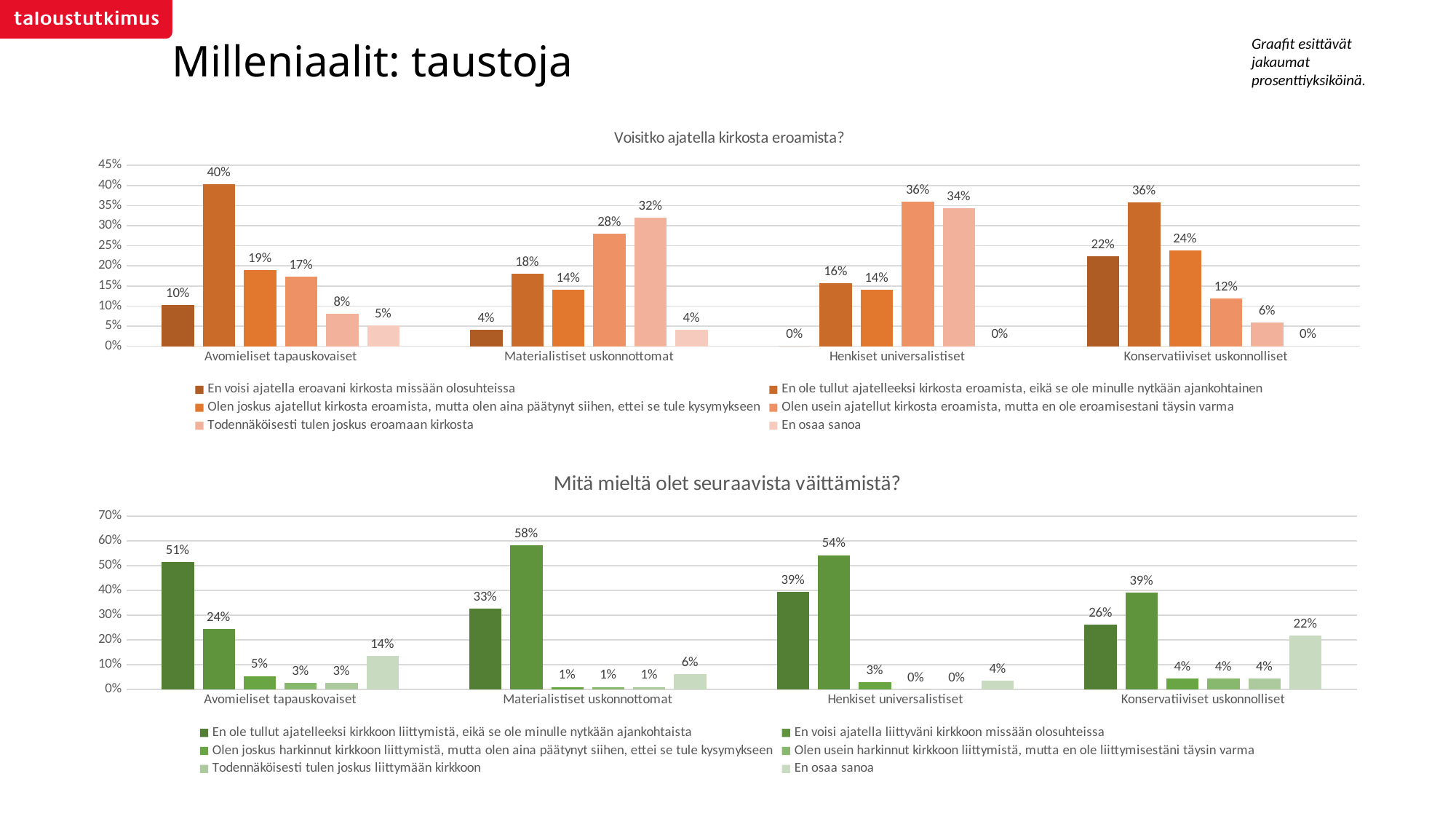
In the bottom chart 'Mitä mieltä olet seuraavista väittämistä?', what is the difference in percentage points between Materialistiset uskonnottomat (58%) and Henkiset universalistiset (54%) for 'En voisi ajatella liittyväni kirkkoon missään olosuhteissa'? 4 percentage points What is the title of the top chart on the slide? Voisitko ajatella kirkosta eroamista? In the bottom chart 'Mitä mieltä olet seuraavista väittämistä?', which category has the single highest bar, and what is its value? Materialistiset uskonnottomat, 58% How many categories are shown on the x axis of the top chart 'Voisitko ajatella kirkosta eroamista?'? 4 What kind of chart is the bottom chart 'Mitä mieltä olet seuraavista väittämistä?'? Bar chart In the top chart 'Voisitko ajatella kirkosta eroamista?', which category has the highest value for 'En voisi ajatella eroavani kirkosta missään olosuhteissa'? Konservatiiviset uskonnolliset In the bottom chart 'Mitä mieltä olet seuraavista väittämistä?', which is larger for 'En ole tullut ajatelleeksi kirkkoon liittymistä, eikä se ole minulle nytkään ajankohtaista': Avomieliset tapauskovaiset or Henkiset universalistiset? Avomieliset tapauskovaiset In the bottom chart 'Mitä mieltä olet seuraavista väittämistä?', what is the value of 'En osaa sanoa' for Konservatiiviset uskonnolliset? 22% How many series does the legend of the top chart 'Voisitko ajatella kirkosta eroamista?' list? 6 In the top chart 'Voisitko ajatella kirkosta eroamista?', what is the difference in percentage points between Avomieliset tapauskovaiset (40%) and Konservatiiviset uskonnolliset (36%) for 'En ole tullut ajatelleeksi kirkosta eroamista, eikä se ole minulle nytkään ajankohtainen'? 4 percentage points In the top chart 'Voisitko ajatella kirkosta eroamista?', what is the value of 'En osaa sanoa' for Avomieliset tapauskovaiset? 5% In the top chart 'Voisitko ajatella kirkosta eroamista?', what is the value of 'Olen usein ajatellut kirkosta eroamista, mutta en ole eroamisestani täysin varma' for Henkiset universalistiset? 36%